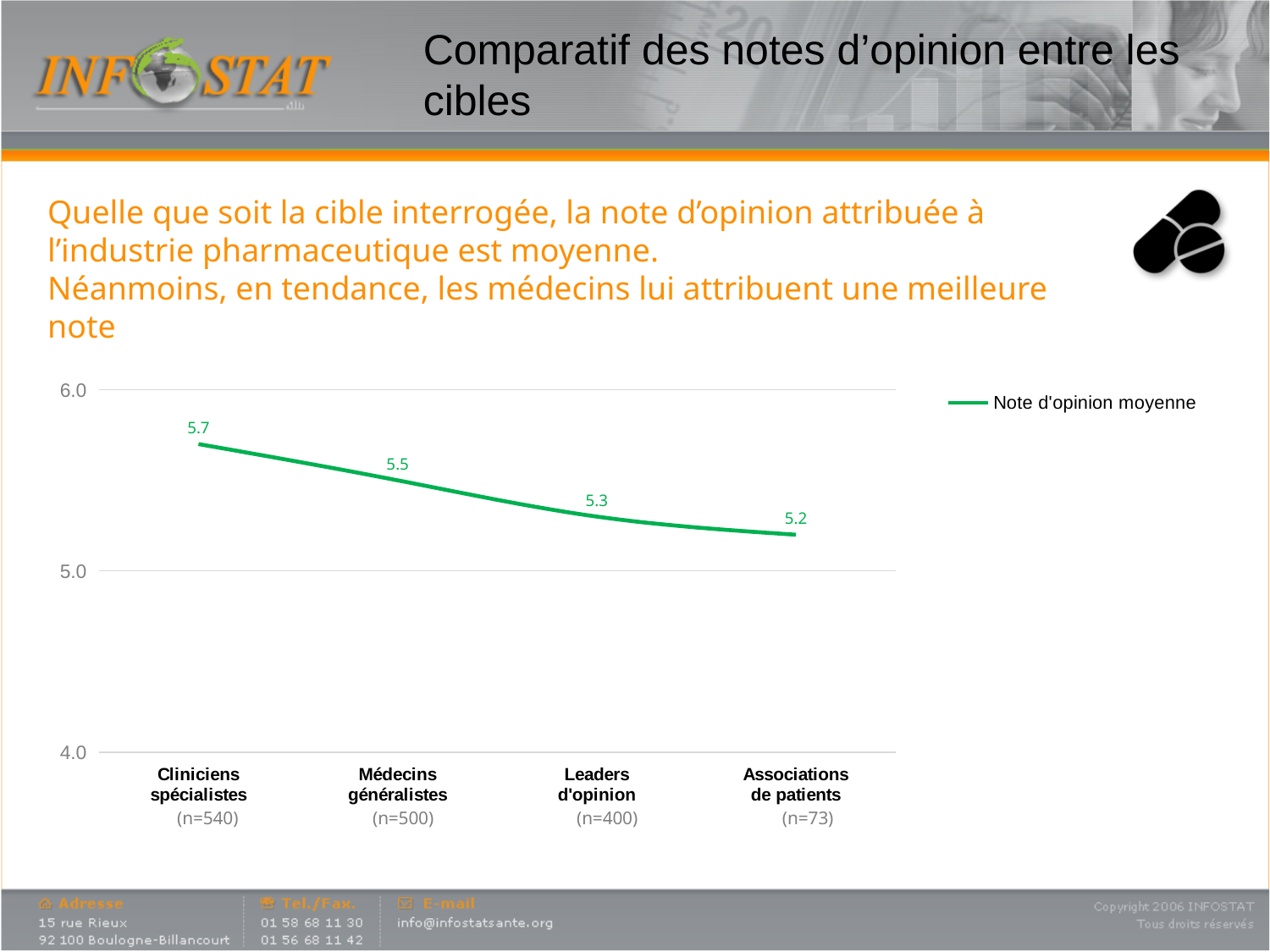
What kind of chart is shown on the slide? Line chart What is the average opinion score for Médecins généralistes? 5.5 What is the difference between the opinion scores of Cliniciens spécialistes and Associations de patients? 0.5 Which target group gives the lowest average opinion score? Associations de patients How many target groups are plotted on the chart? 4 Do the opinion scores rise or fall from left to right across the target groups? Fall What is the average opinion score for Leaders d'opinion? 5.3 What is the average opinion score (Note d'opinion moyenne) for Cliniciens spécialistes? 5.7 Which group has a higher opinion score: Médecins généralistes or Leaders d'opinion? Médecins généralistes Which target group gives the highest average opinion score? Cliniciens spécialistes What is the average opinion score for Associations de patients? 5.2 How many series does the legend list? 1